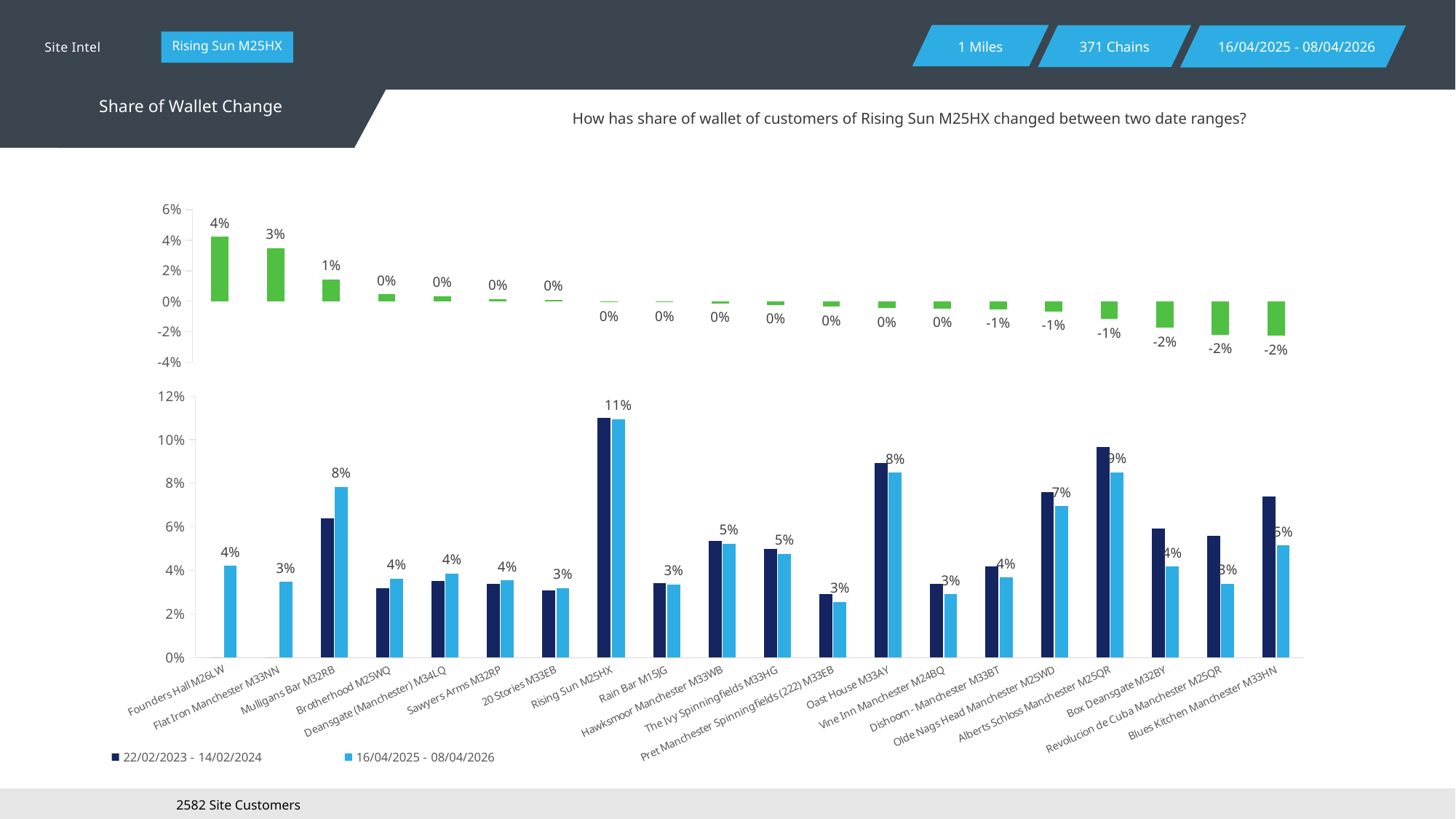
In the top chart, which category has the highest value? Founders Hall M26LW In the bottom chart, is the value for Alberts Schloss Manchester M25QR in the 22/02/2023 - 14/02/2024 series greater or less than 8%? greater In the top chart, what is the value for Founders Hall M26LW? 4% What kind of chart is the top chart? Bar chart In the top chart, what is the value for Mulligans Bar M32RB? 1% How many categories are shown on the x axis of the bottom chart? 20 In the bottom chart, what is the value for Mulligans Bar M32RB in the 16/04/2025 - 08/04/2026 series? 8% In the bottom chart, what is the value for Rising Sun M25HX in the 16/04/2025 - 08/04/2026 series? 11% In the bottom chart, which category has the highest value in the 16/04/2025 - 08/04/2026 series? Rising Sun M25HX In the bottom chart, for Mulligans Bar M32RB, which series has the larger value? 16/04/2025 - 08/04/2026 In the bottom chart, how many series does the legend list? 2 In the top chart, what is the value for Blues Kitchen Manchester M33HN? -2%